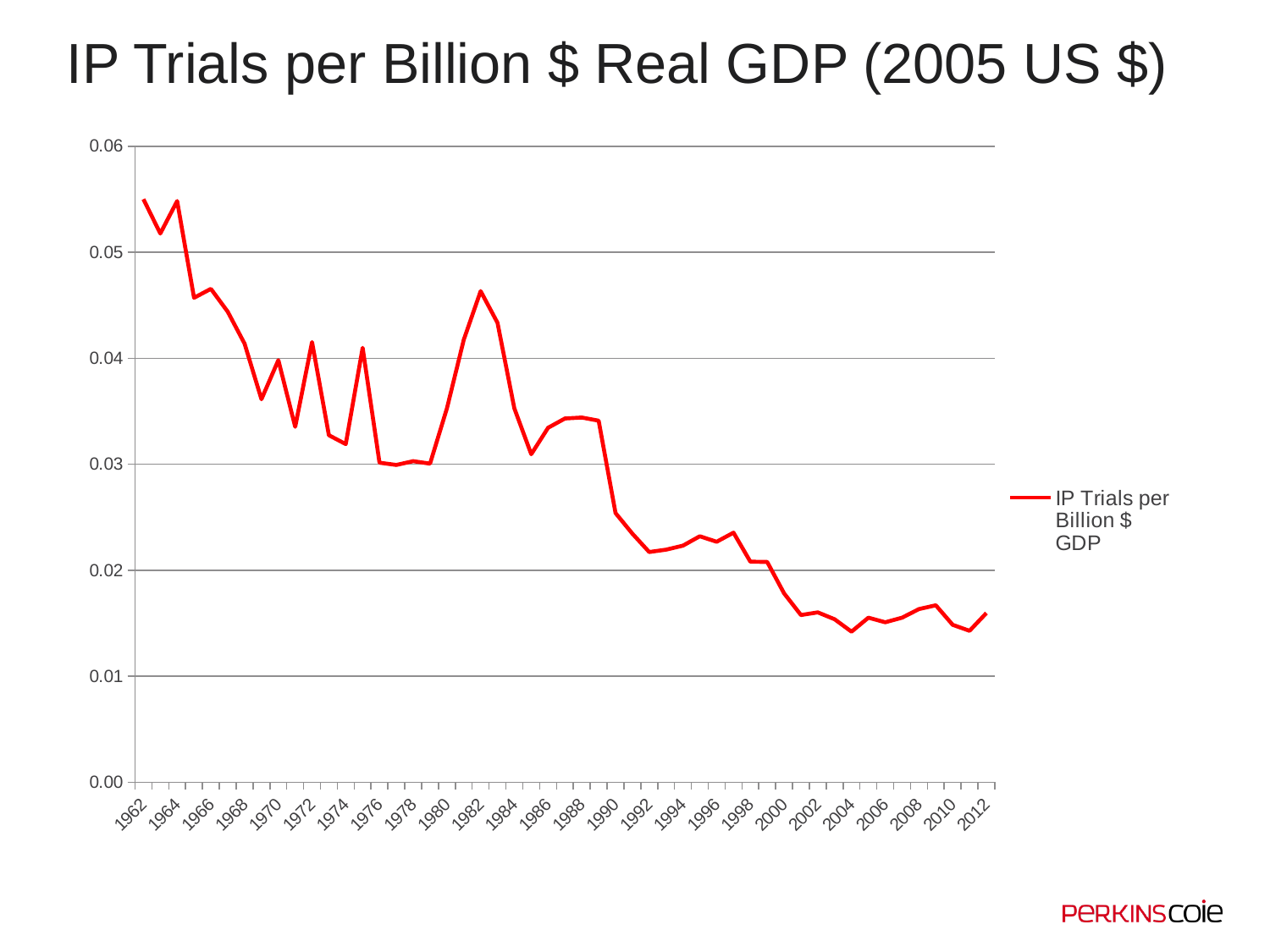
Is the value for 1966 greater or less than 0.04? greater Which year has the larger value, 1982 or 1992? 1982 What kind of chart is shown on the slide? Line chart Is the value for 1962 greater or less than 0.05? greater Is the value for 1992 greater or less than 0.03? less Overall, do the values rise or fall from 1962 to 2012? Fall Which year has the larger value, 1962 or 2012? 1962 How many series does the legend list? 1 What is the legend entry for the plotted line? IP Trials per Billion $ GDP What colour is the plotted line? Red